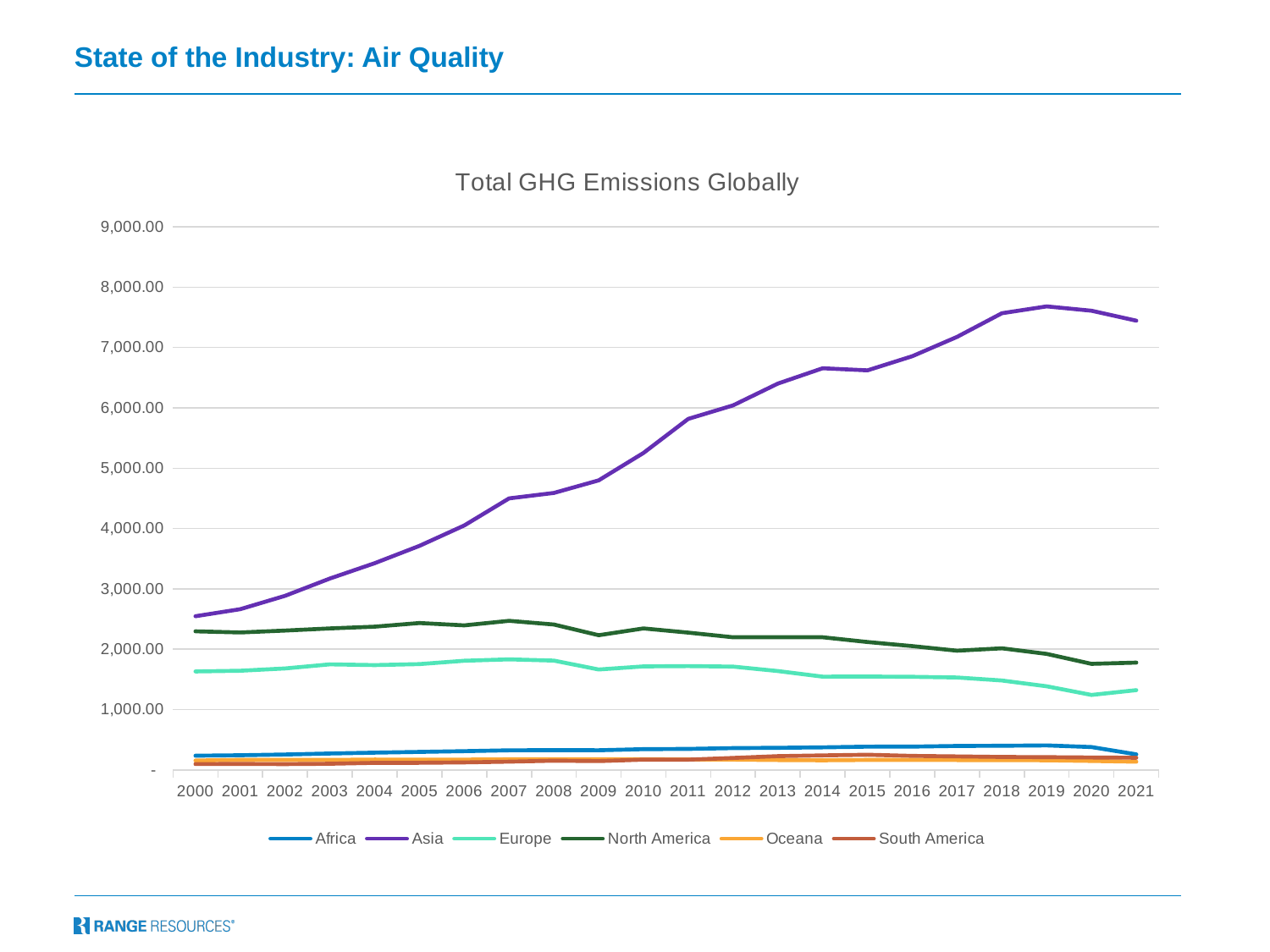
Is the value for Asia in 2021 greater or less than 8,000.00? less What is the title of the chart? Total GHG Emissions Globally Is the value for North America in 2007 greater or less than 2,000.00? greater Which region has the highest emissions in 2021? Asia Do the values for Asia generally rise or fall from 2000 to 2019? Rise Which colour is used for the Asia line in the legend? Purple Is the value for Europe in 2007 greater or less than 2,000.00? less How many series does the legend list? 6 Which is larger in 2010, the value for Europe or the value for North America? North America What kind of chart is shown on the slide? Line chart How many years are shown along the x axis? 22